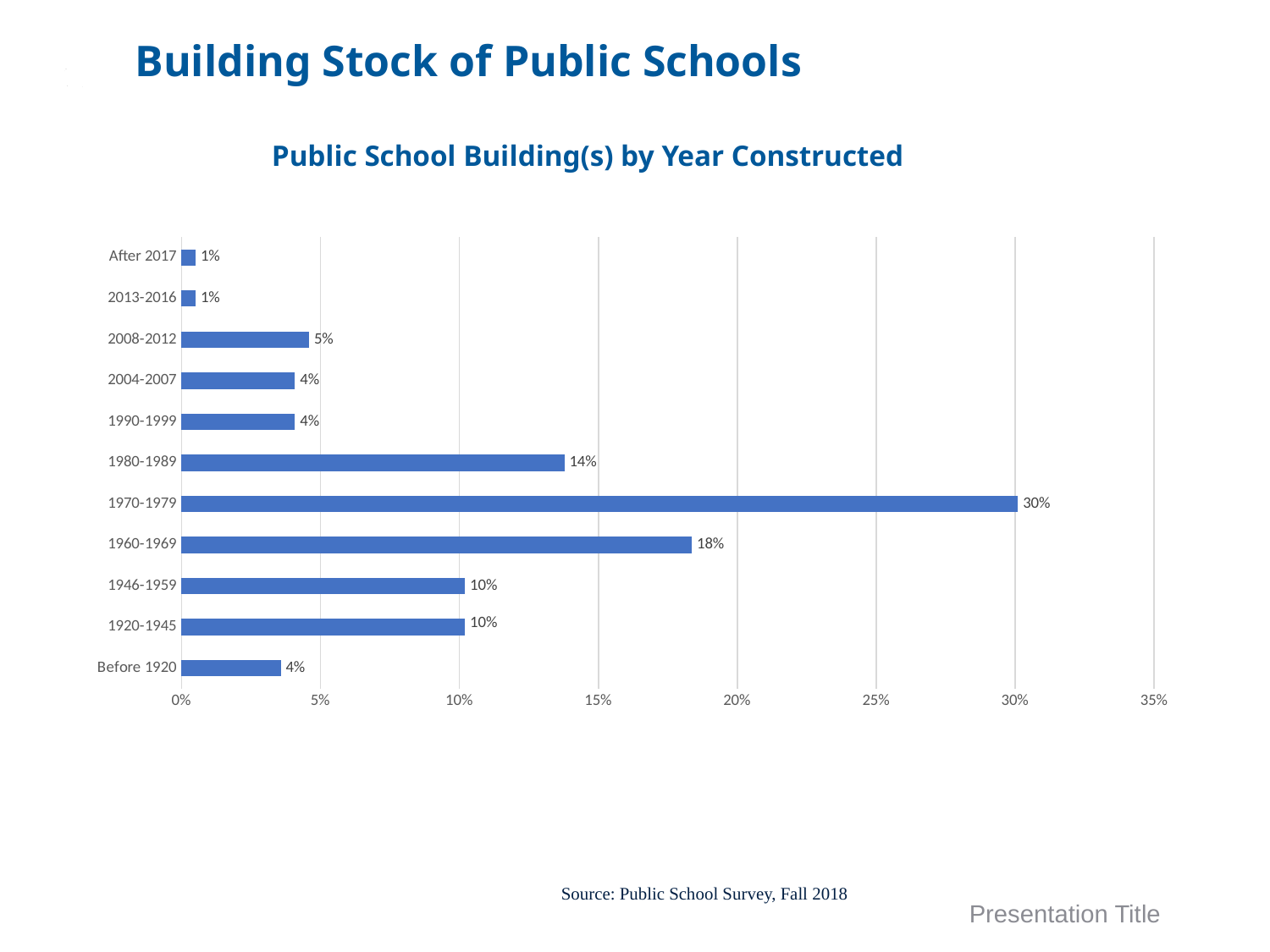
What percentage of public school buildings were constructed in 1970-1979? 30% What is the value shown for the 1960-1969 category? 18% What is the difference between the values for 1970-1979 and 1960-1969? 12% Is the value for 1960-1969 greater or less than 15%? greater Which year range has the highest percentage of public school buildings? 1970-1979 How many year-range categories are shown in the chart? 11 What is the source cited for the chart data? Public School Survey, Fall 2018 Which is larger, the value for 1980-1989 or the value for 1946-1959? 1980-1989 What is the difference between the values for 1980-1989 and 2008-2012? 9% What kind of chart is shown on the slide? Bar chart What is the title of the chart? Public School Building(s) by Year Constructed What percentage of buildings were constructed before 1920? 4%